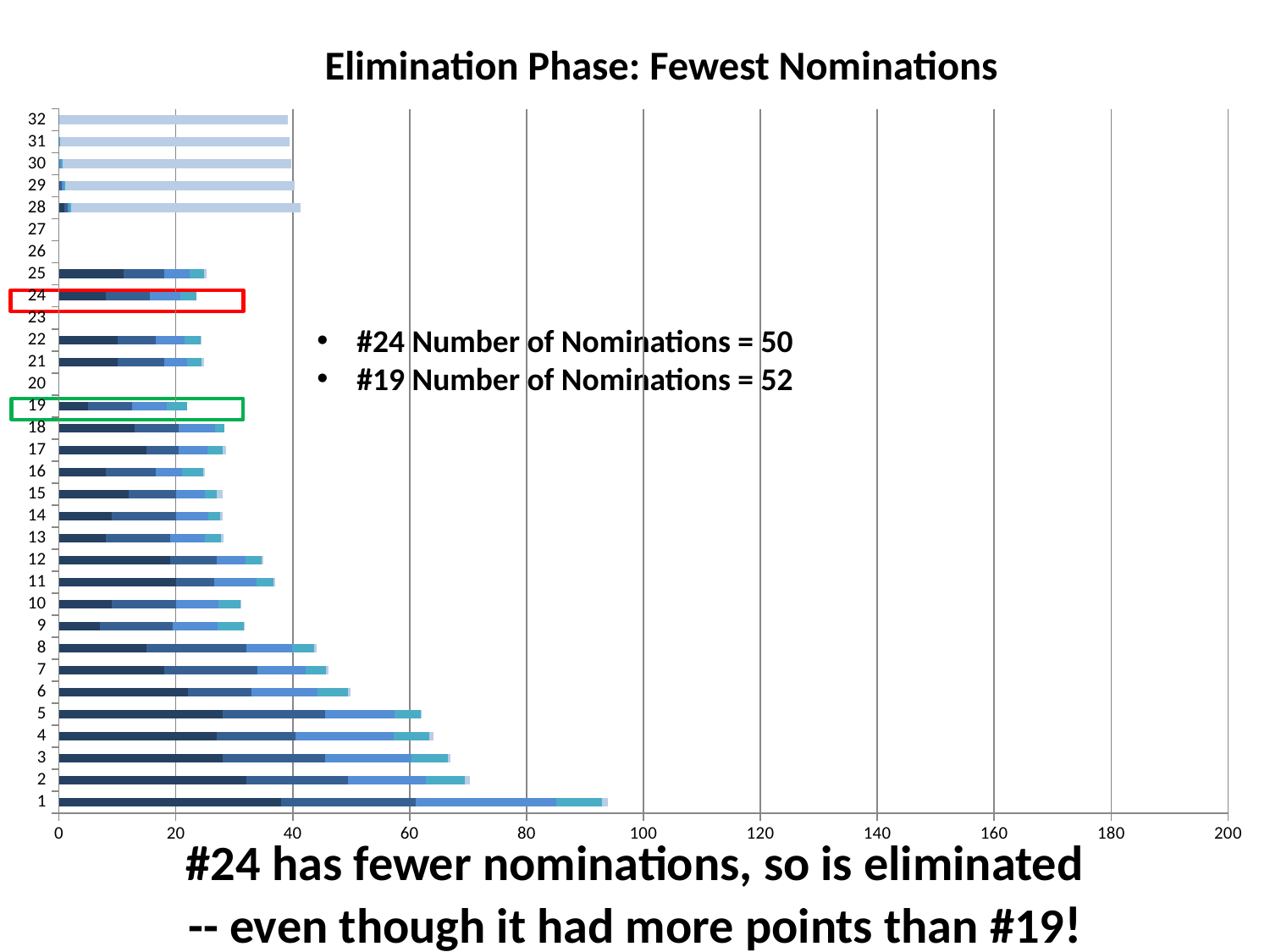
Which category has the longest bar in the chart? 1 Is the total bar length for category 2 greater or less than 60? greater Is the total bar length for category 12 greater or less than 40? less Which has the longer bar, category 8 or category 9? 8 Is the total bar length for category 6 greater or less than 40? greater How many categories are labelled on the vertical axis of the chart? 32 What is the title of the chart? Elimination Phase: Fewest Nominations What is the highest value shown on the horizontal axis of the chart? 200 What kind of chart is shown on the slide? bar chart Which has the longer bar, category 11 or category 10? 11